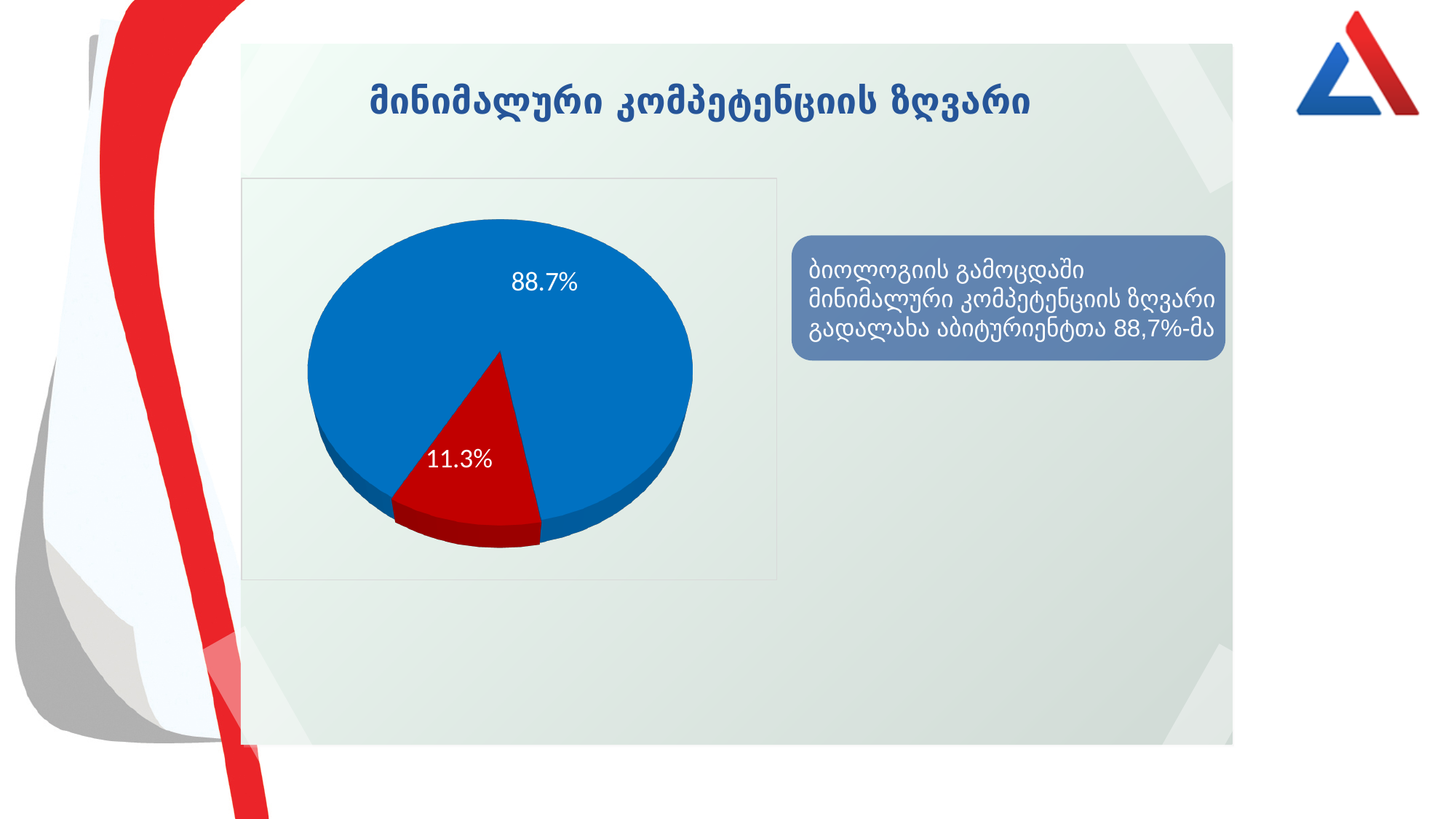
What is the difference between the blue slice and the red slice of the pie chart? 77.4% What value is shown on the blue slice of the pie chart? 88.7% What value is shown on the red slice of the pie chart? 11.3% What kind of chart is shown on the slide? pie chart Which is larger, the blue slice or the red slice? the blue slice What do the two slices of the pie chart add up to? 100% What share of the pie does the red slice represent? 11.3% How many slices does the pie chart have? 2 Which slice of the pie chart is the largest? the blue slice (88.7%) What is the title of the slide containing the pie chart? მინიმალური კომპეტენციის ზღვარი Which slice of the pie chart is the smallest? the red slice (11.3%) What colour is the slice labelled 88.7%? blue